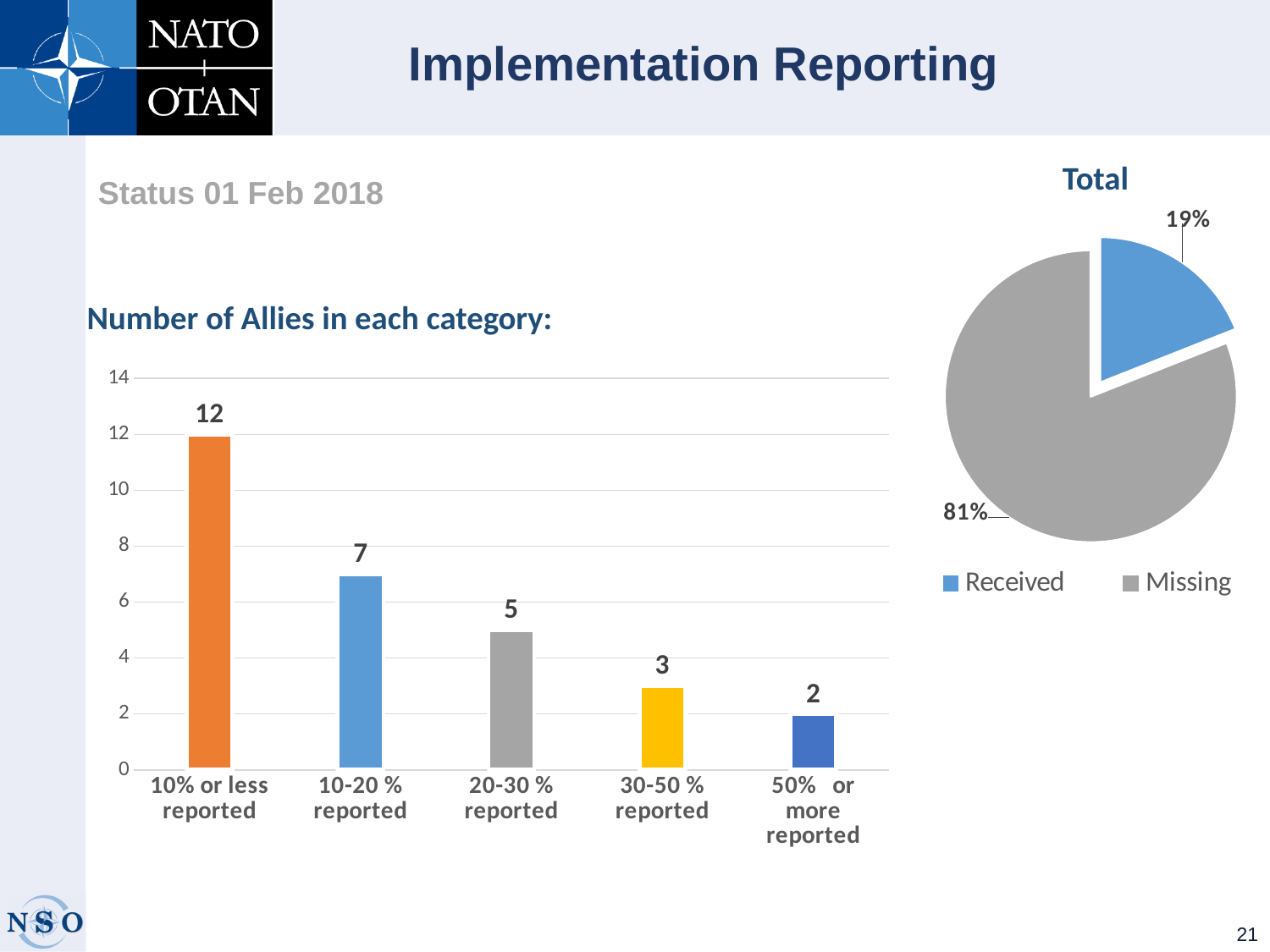
In the bar chart 'Number of Allies in each category', what is the value for '30-50 % reported'? 3 In the bar chart 'Number of Allies in each category', which category has the lowest value? 50% or more reported Do the values in the bar chart 'Number of Allies in each category' rise or fall from left to right? fall How many entries does the legend of the pie chart titled 'Total' list? 2 In the bar chart 'Number of Allies in each category', which category has the highest value? 10% or less reported In the bar chart 'Number of Allies in each category', how many Allies are in the '10% or less reported' category? 12 In the pie chart titled 'Total', what share is 'Missing'? 81% In the bar chart 'Number of Allies in each category', what is the difference between the '10-20 % reported' and '20-30 % reported' values? 2 How many categories are shown in the bar chart 'Number of Allies in each category'? 5 In the pie chart titled 'Total', what share is 'Received'? 19% In the bar chart 'Number of Allies in each category', which is larger: '20-30 % reported' or '50% or more reported'? 20-30 % reported What kind of chart is the chart on the left of the slide? bar chart